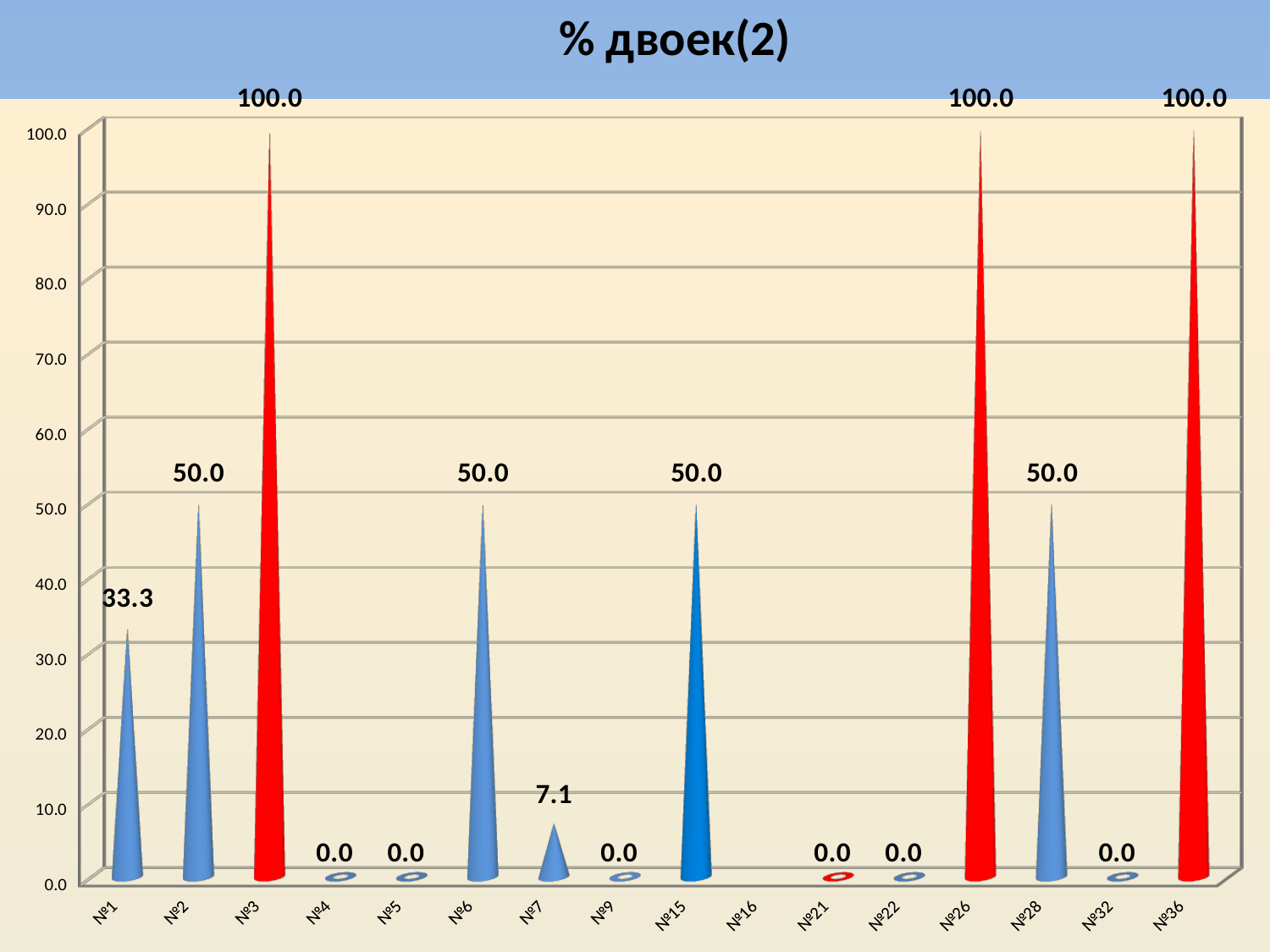
What is the value for №28? 50.0 What is the value for №1? 33.3 Which has the larger value, №15 or №7? №15 What is the value for №7? 7.1 How many categories are shown on the x axis? 16 What is the value for №26? 100.0 What is the difference between the values for №6 and №7? 42.9 What is the highest value shown on the chart? 100.0 Is the value for №1 greater or less than 30.0? greater What is the title of the chart? % двоек(2) What kind of chart is this? bar chart What is the difference between the values for №2 and №1? 16.7